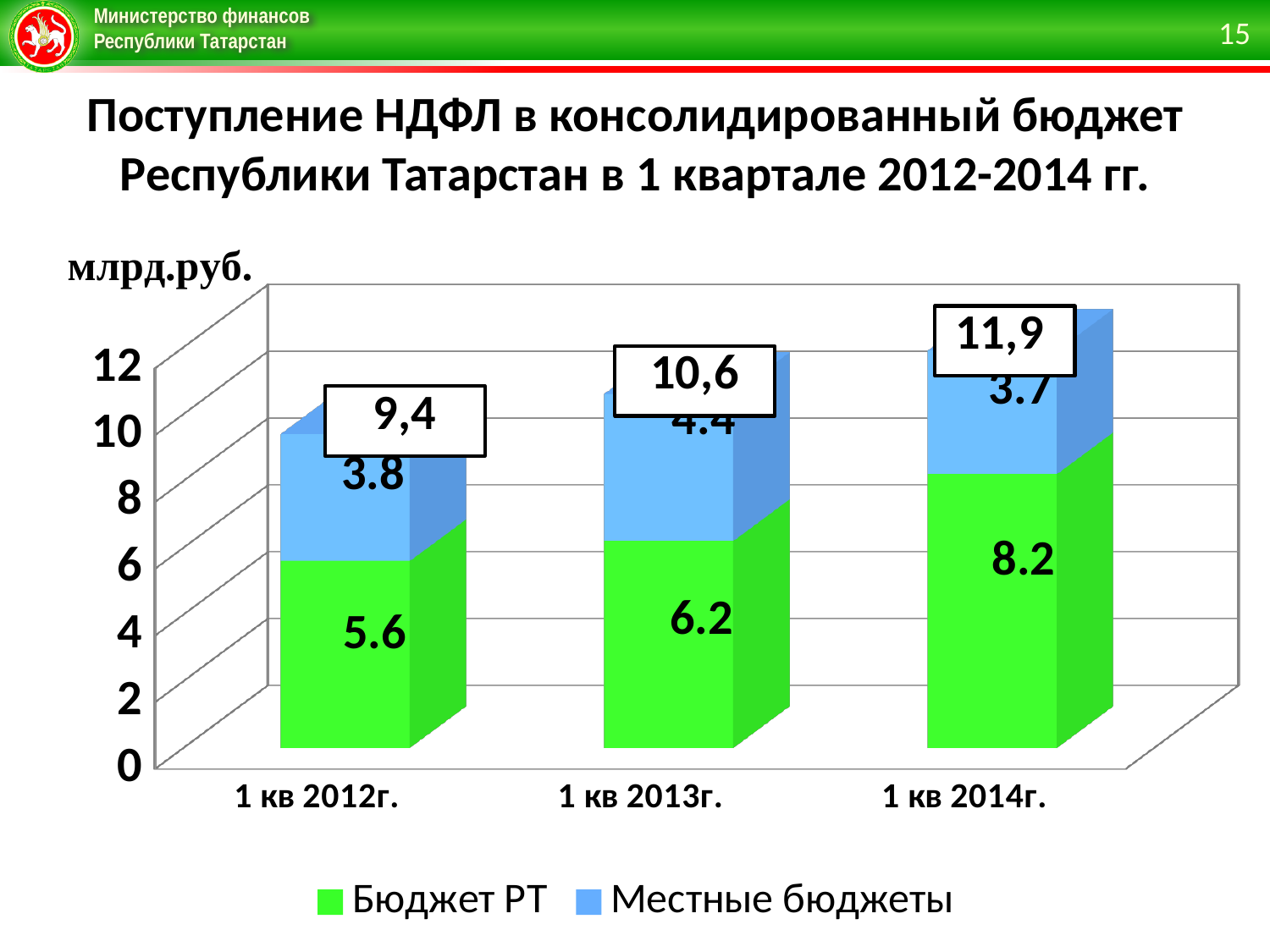
Which period has the lowest total? 1 кв 2012г. What is the total of the stacked bar for 1 кв 2013г.? 10,6 What is the total of the stacked bar for 1 кв 2014г.? 11,9 What kind of chart is shown on the slide? Stacked bar chart What is the value for Бюджет РТ in 1 кв 2014г.? 8.2 What is the value for Местные бюджеты in 1 кв 2012г.? 3.8 Do the totals rise or fall from 1 кв 2012г. to 1 кв 2014г.? Rise How many series does the legend list? 2 What is the value for Бюджет РТ in 1 кв 2012г.? 5.6 What is the difference between the Бюджет РТ values for 1 кв 2014г. and 1 кв 2012г.? 2.6 What is the value for Местные бюджеты in 1 кв 2014г.? 3.7 Which period has the highest value for Бюджет РТ? 1 кв 2014г.